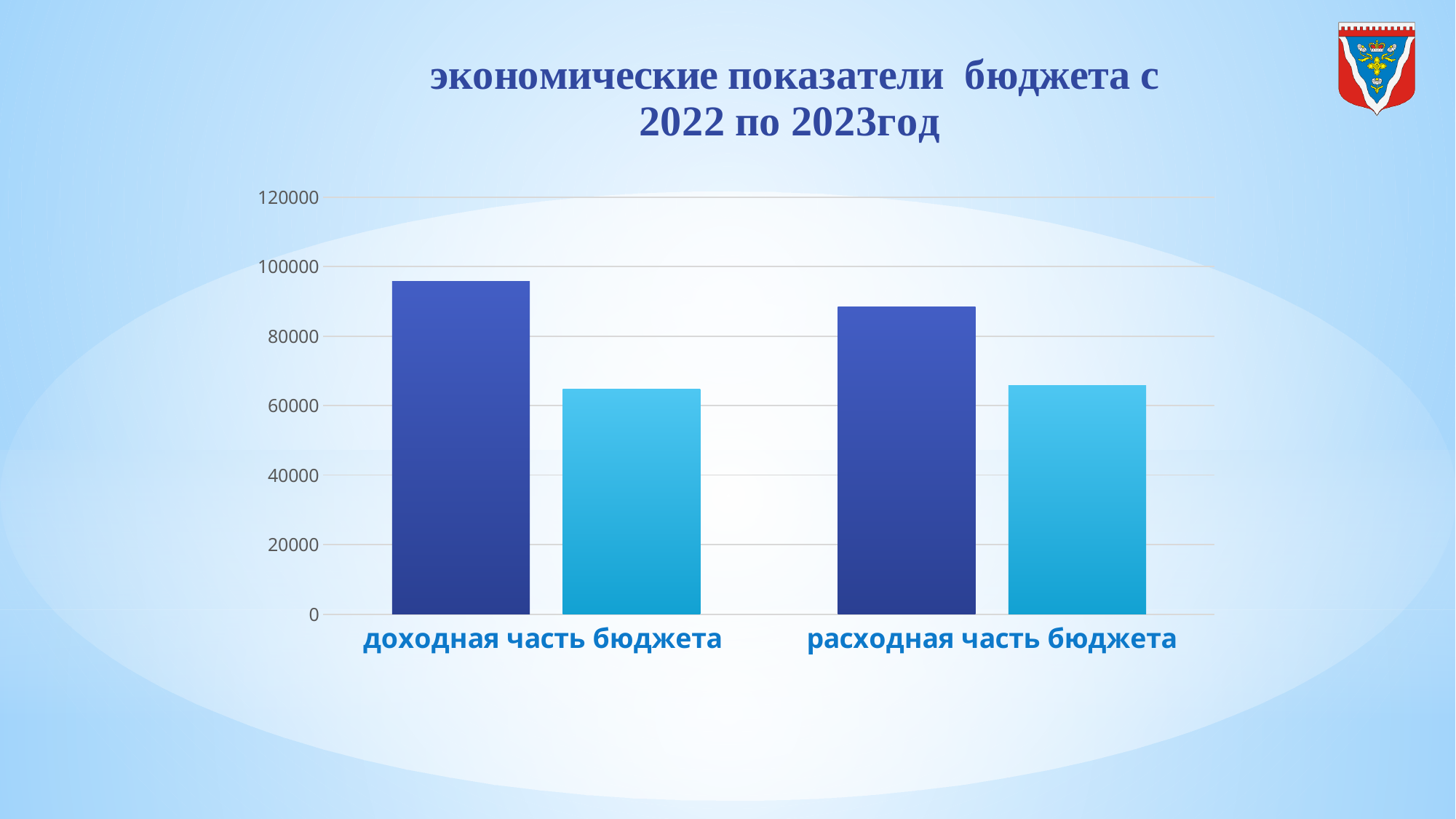
What kind of chart is shown on the slide? bar chart Which bar on the chart is the tallest overall? the dark blue bar for доходная часть бюджета Is the value of the dark blue bar for "расходная часть бюджета" greater or less than 80000? greater For "доходная часть бюджета", which bar is taller, the dark blue one or the light blue one? the dark blue one How many bars are shown for each category on the chart? 2 Is the value of the dark blue bar for "доходная часть бюджета" greater or less than 80000? greater What is the title of the chart on the slide? экономические показатели бюджета с 2022 по 2023год Which category has the taller dark blue bar, "доходная часть бюджета" or "расходная часть бюджета"? доходная часть бюджета How many categories are shown on the x axis of the chart? 2 Is the value of the light blue bar for "доходная часть бюджета" greater or less than 60000? greater